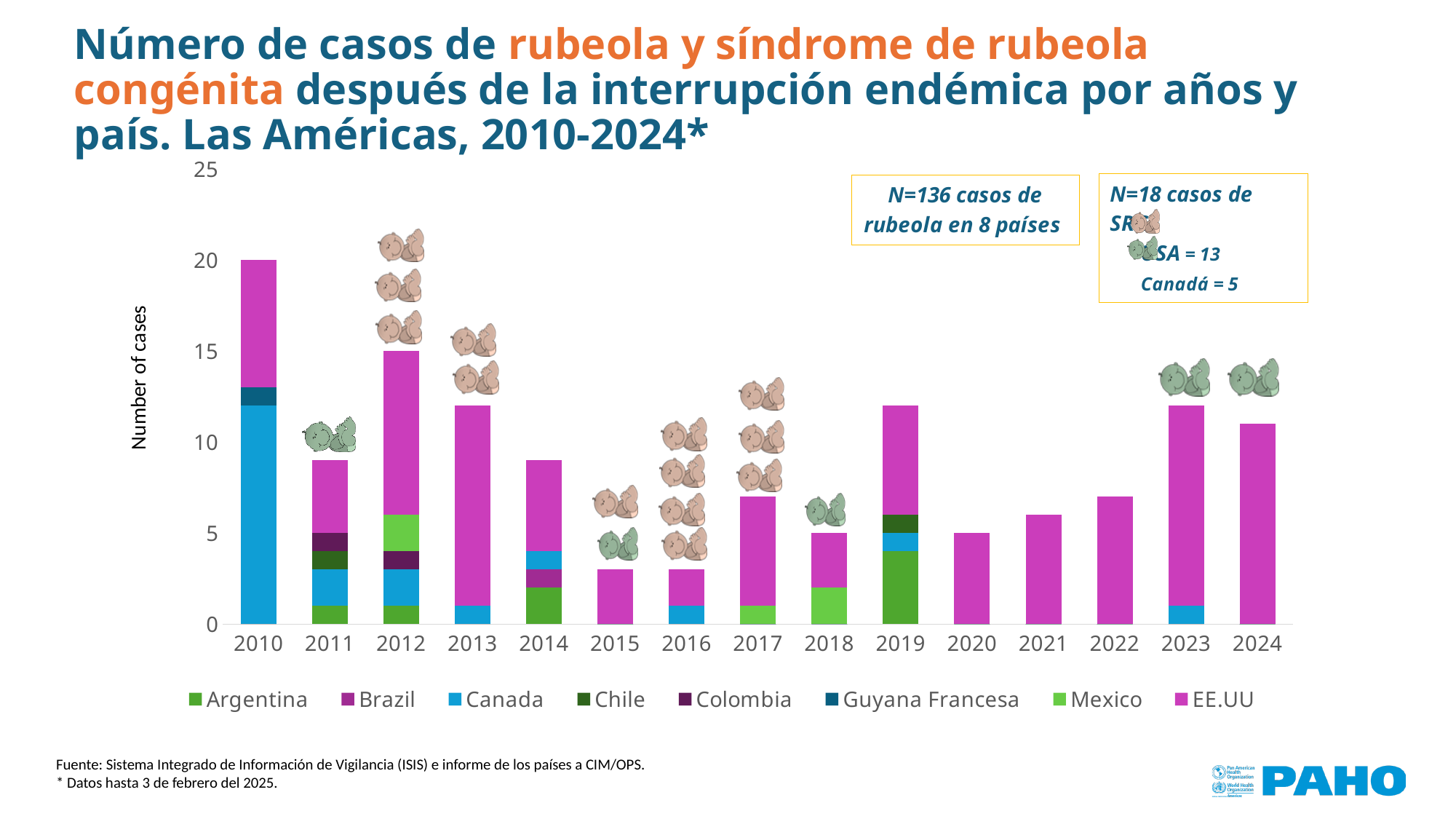
Is the total for 2013 greater or less than 10? greater How many series does the chart's legend list? 8 Do the bar totals rise or fall from 2020 to 2023? rise What is the total number of cases for the 2020 bar? 5 According to the text box on the chart, how many rubella cases were reported and in how many countries? N=136 casos de rubeola en 8 países Is the total for 2022 greater or less than 10? less What is the total number of cases for the 2010 bar? 20 How many years are shown along the x axis of the chart? 15 What is the total number of cases for the 2012 bar? 15 Which year has a higher total, 2019 or 2020? 2019 Which year has the highest total number of cases? 2010 What kind of chart is shown on the slide? bar chart